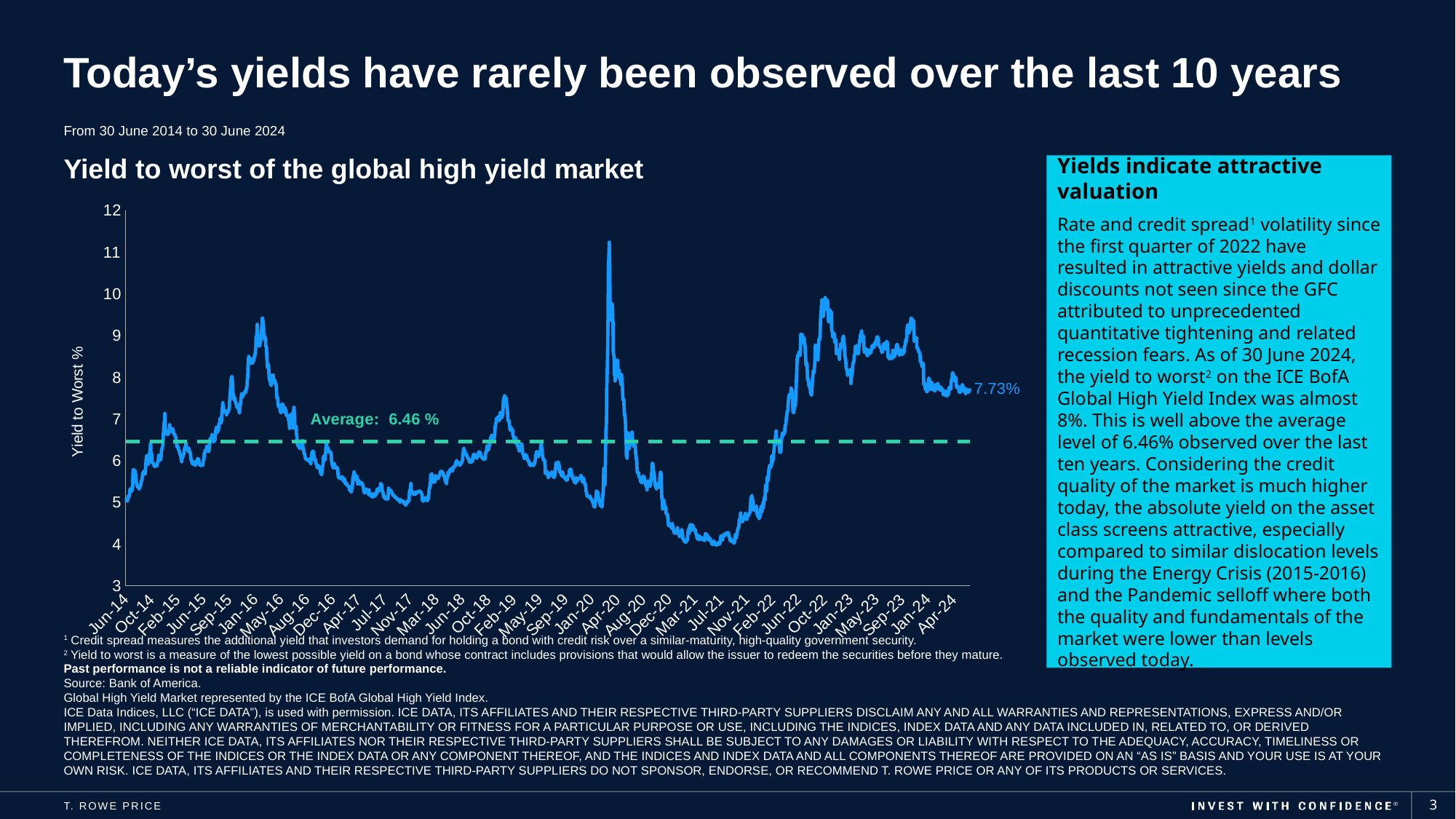
Is the value around Jul-21 greater or less than 5? less Is the value at Jun-14, the start of the series, greater or less than 6? less Which peak is higher: the one around Jan-16 or the one around Apr-20? Apr-20 What average value is shown by the dashed line on the chart? 6.46 % What is the label on the vertical axis of the chart? Yield to Worst % Is the peak around Oct-22 greater or less than 9? greater What is the yield to worst value labelled at the end of the line (latest point)? 7.73% Is the latest labelled value of 7.73% above or below the average line of 6.46 %? above What kind of chart is shown on the slide? line chart Does the yield rise or fall between Jan-20 and Apr-20? rise By how much does the latest labelled value (7.73%) exceed the average (6.46 %)? 1.27 percentage points